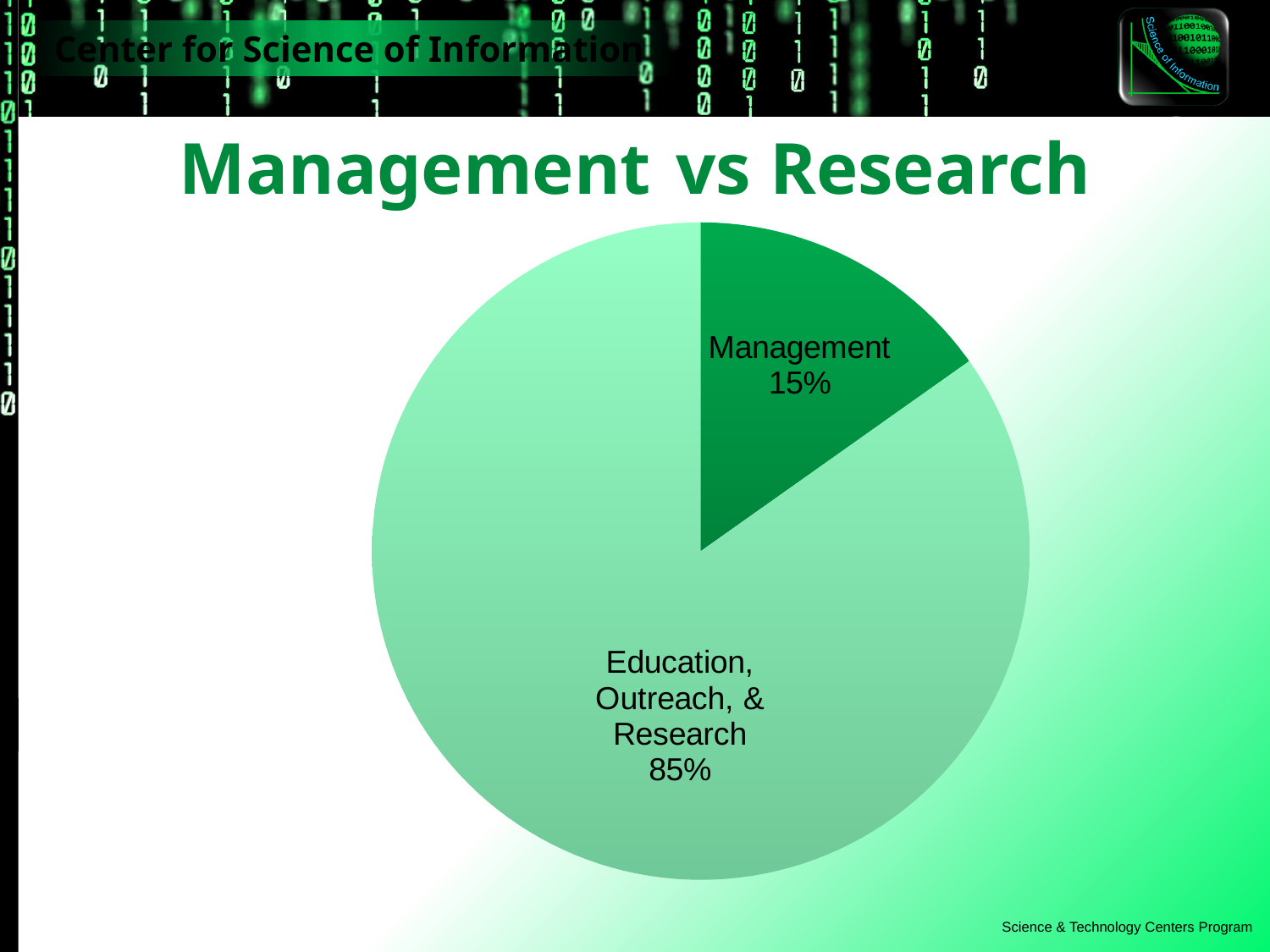
How many slices does the pie chart have? 2 Which slice of the pie is the smallest? Management Which slice is drawn in the darker green colour? Management What percentage of the pie is Education, Outreach, & Research? 85% What percentage of the pie is Management? 15% What is the title of the chart on the slide? Management vs Research What type of chart is shown on the slide? Pie chart What share of the pie does the Management slice represent? 15% Which slice of the pie is the largest? Education, Outreach, & Research Which is larger, the Management slice or the Education, Outreach, & Research slice? Education, Outreach, & Research What is the difference in percentage points between the Education, Outreach, & Research slice and the Management slice? 70